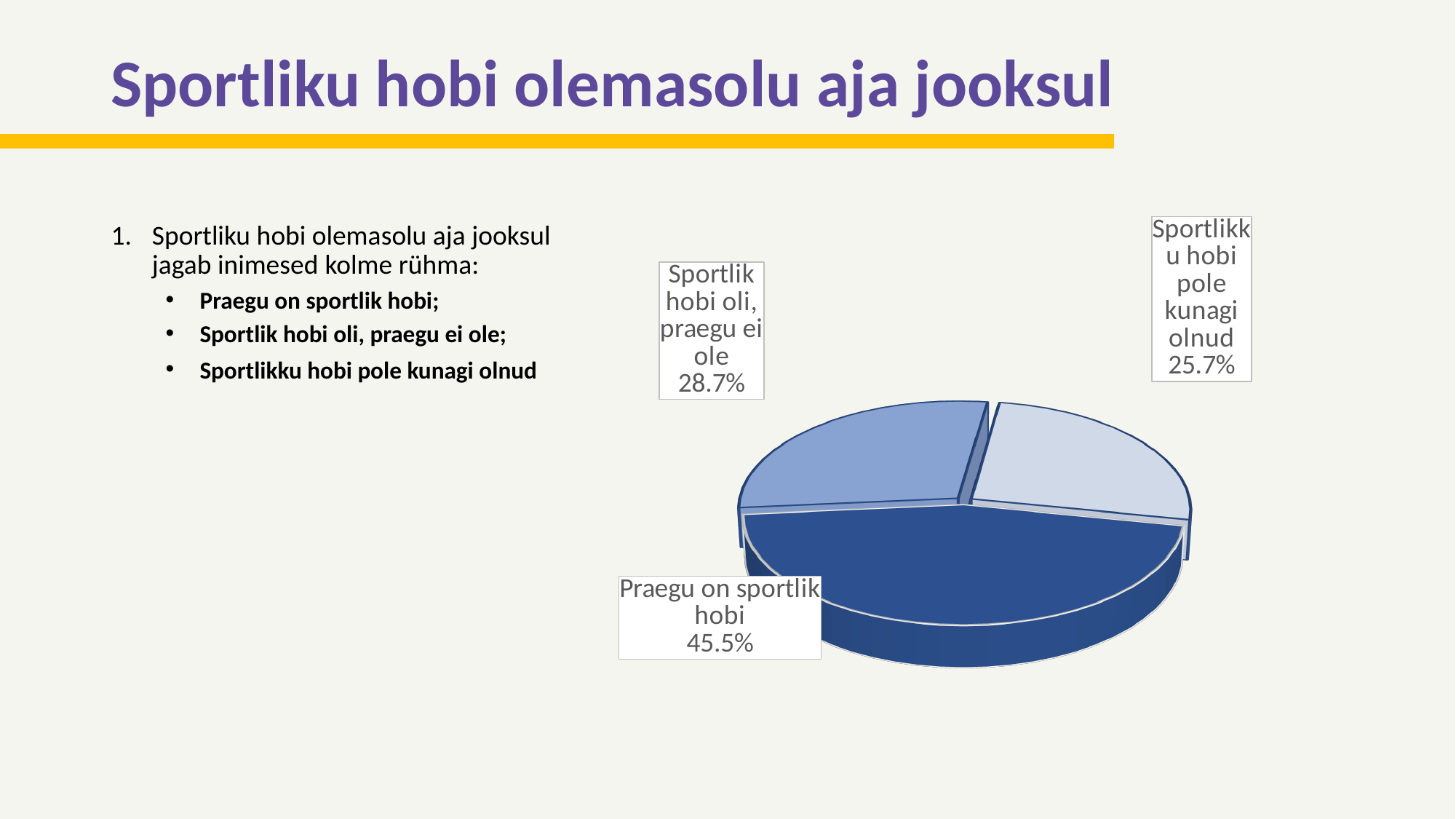
Is the share for "Praegu on sportlik hobi" greater or less than 50%? less How many slices does the pie chart have? 3 What kind of chart is shown on the slide? Pie chart Which category has the smallest slice of the pie? Sportlikku hobi pole kunagi olnud What is the difference between the shares of "Praegu on sportlik hobi" and "Sportlik hobi oli, praegu ei ole"? 16.8% Which is larger: the share for "Sportlik hobi oli, praegu ei ole" or for "Sportlikku hobi pole kunagi olnud"? Sportlik hobi oli, praegu ei ole What is the difference between the shares of "Sportlik hobi oli, praegu ei ole" and "Sportlikku hobi pole kunagi olnud"? 3.0% What share of the pie does "Praegu on sportlik hobi" represent? 45.5% What is the value shown for "Sportlikku hobi pole kunagi olnud"? 25.7% Which category has the largest slice of the pie? Praegu on sportlik hobi What is the value shown for "Sportlik hobi oli, praegu ei ole"? 28.7% What is the title of the slide containing the chart? Sportliku hobi olemasolu aja jooksul